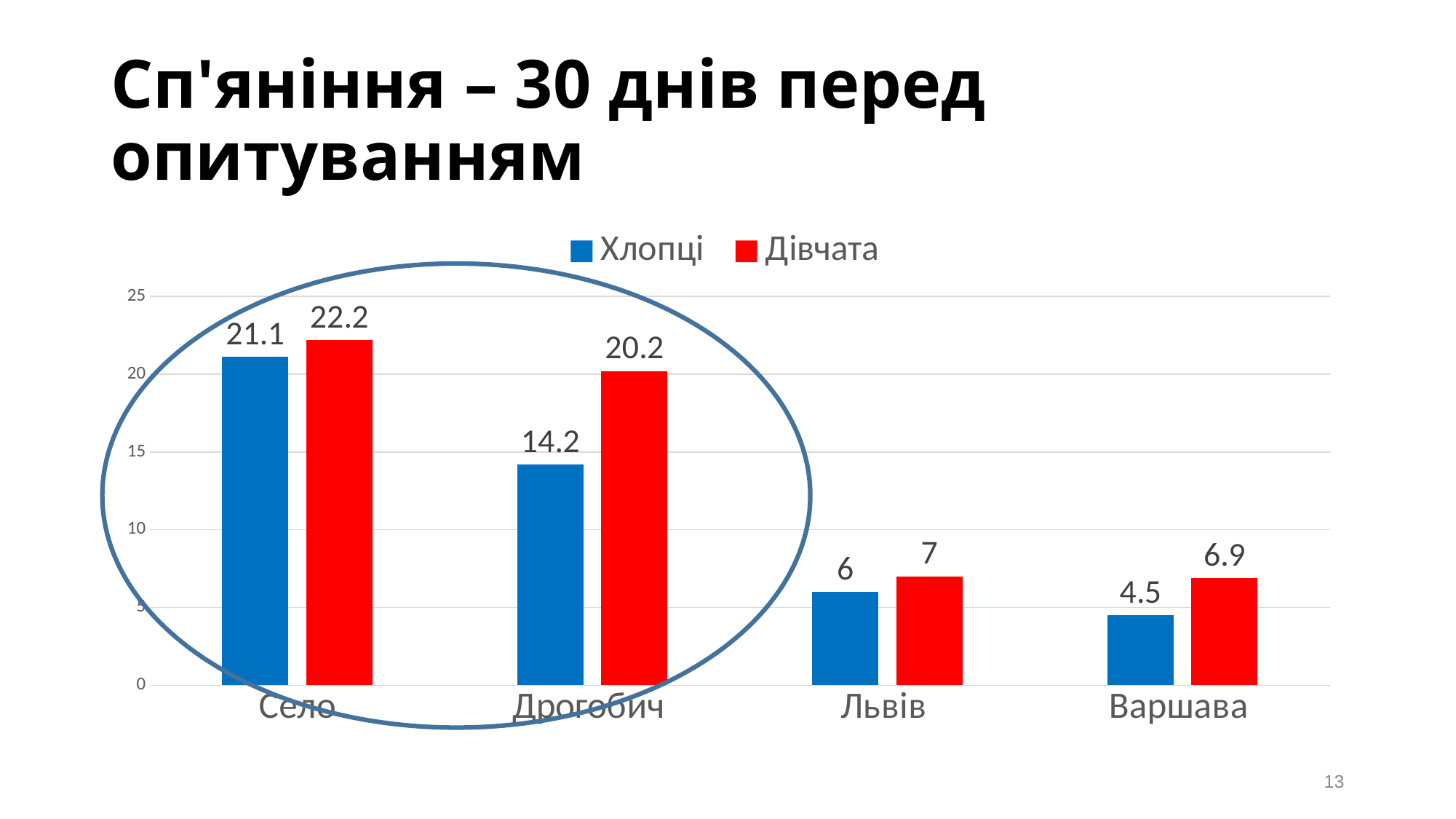
What is the value for Хлопці in Варшава? 4.5 Which category has the highest value for Дівчата? Село How many categories are shown on the x axis? 4 Which category has the lowest value for Хлопці? Варшава Which colour represents the Дівчата series? red What kind of chart is shown on the slide? bar chart What is the value for Хлопці in Село? 21.1 Which is larger in Львів, the value for Хлопці or for Дівчата? Дівчата How many series does the legend list? 2 What is the difference between the Дівчата and Хлопці values in Дрогобич? 6 Is the value for Хлопці in Дрогобич greater or less than 15? less What is the value for Дівчата in Дрогобич? 20.2